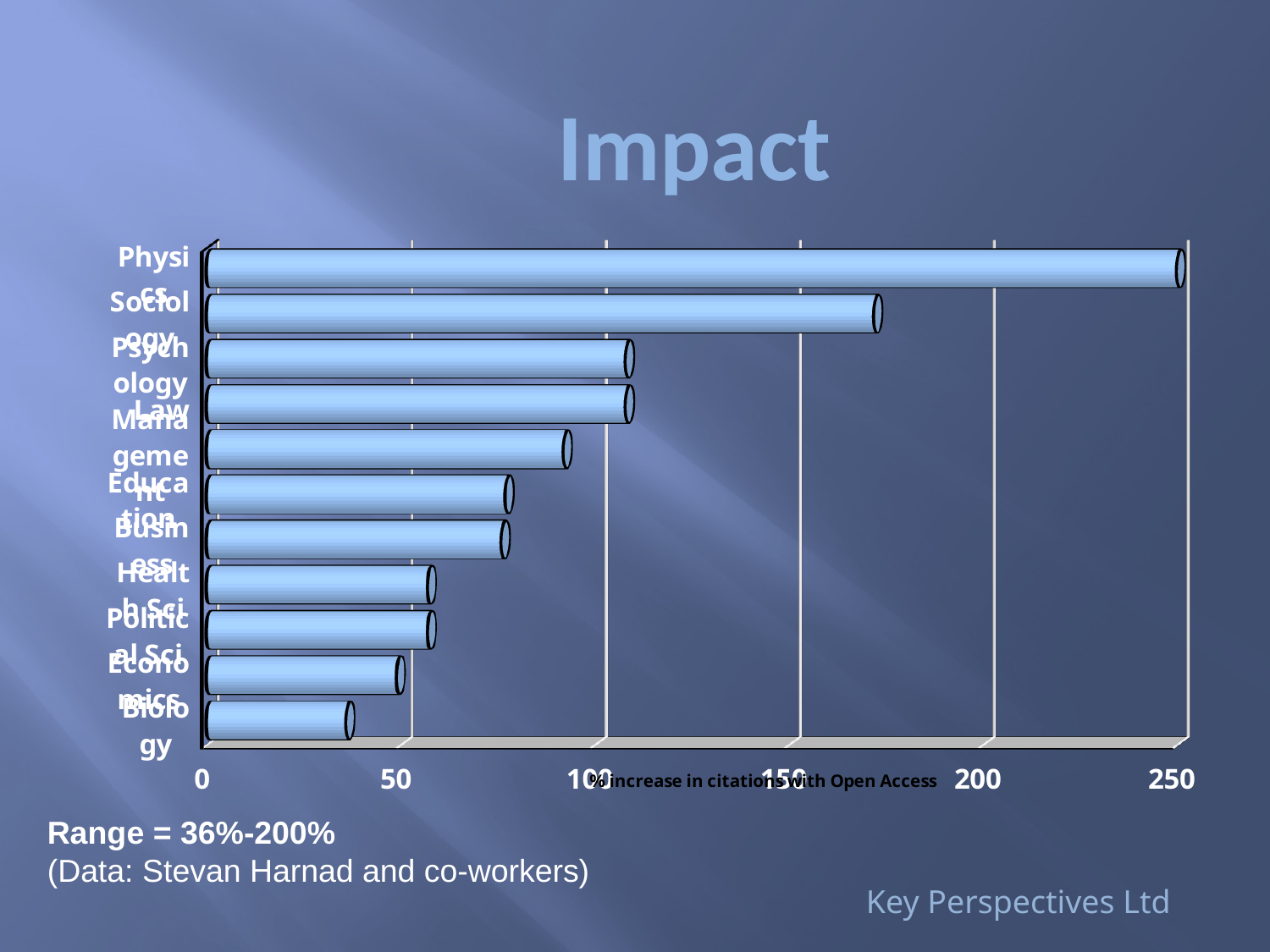
What is the label on the horizontal axis of the chart? % increase in citations with Open Access Is the value for Sociology greater or less than 150? greater What kind of chart is shown on the slide? bar chart What is the title of the slide containing the chart? Impact Which has the larger value, Economics or Education? Education Is the value for Biology greater or less than 50? less How many categories (bars) does the chart show? 11 Which has the larger value, Sociology or Law? Sociology Which category has the highest value in the chart? Physics Is the value for Management greater or less than 100? less Which category has the lowest value in the chart? Biology